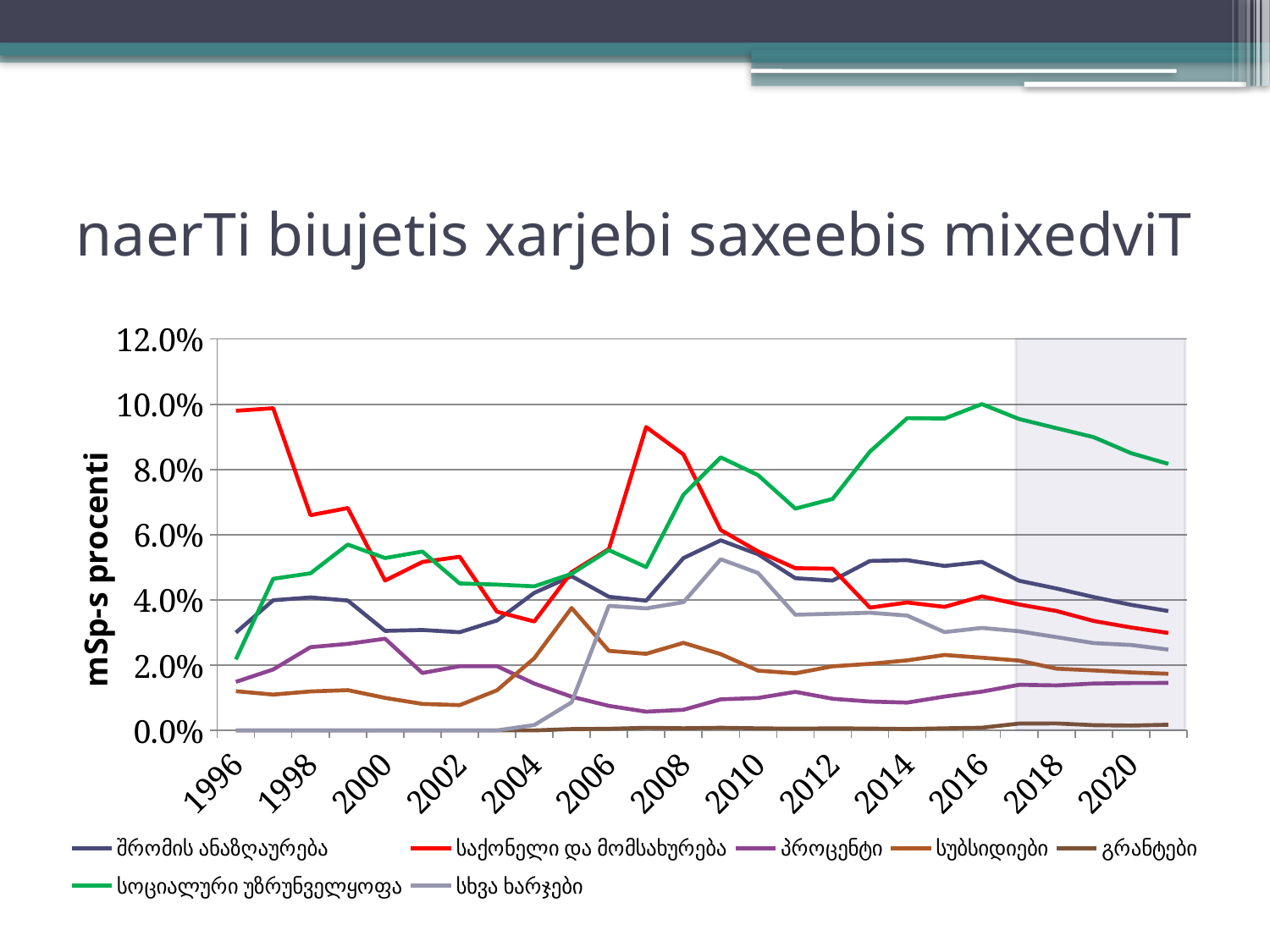
In 1996, which is higher: საქონელი და მომსახურება or სოციალური უზრუნველყოფა? საქონელი და მომსახურება Is the value for საქონელი და მომსახურება in 1996 greater or less than 8.0%? greater Is the value for სოციალური უზრუნველყოფა in 2014 greater or less than 8.0%? greater Is the value for პროცენტი in 2008 greater or less than 2.0%? less What is the title of the chart on the slide? naerTi biujetis xarjebi saxeebis mixedviT What is the label on the vertical axis? mSp-s procenti What kind of chart is shown on the slide? line chart How many series does the legend list? 7 Which series has the highest value in 2016? სოციალური უზრუნველყოფა Does the სოციალური უზრუნველყოფა line rise or fall from 2016 to the end of the chart? fall Which series has the lowest value in 2016? გრანტები